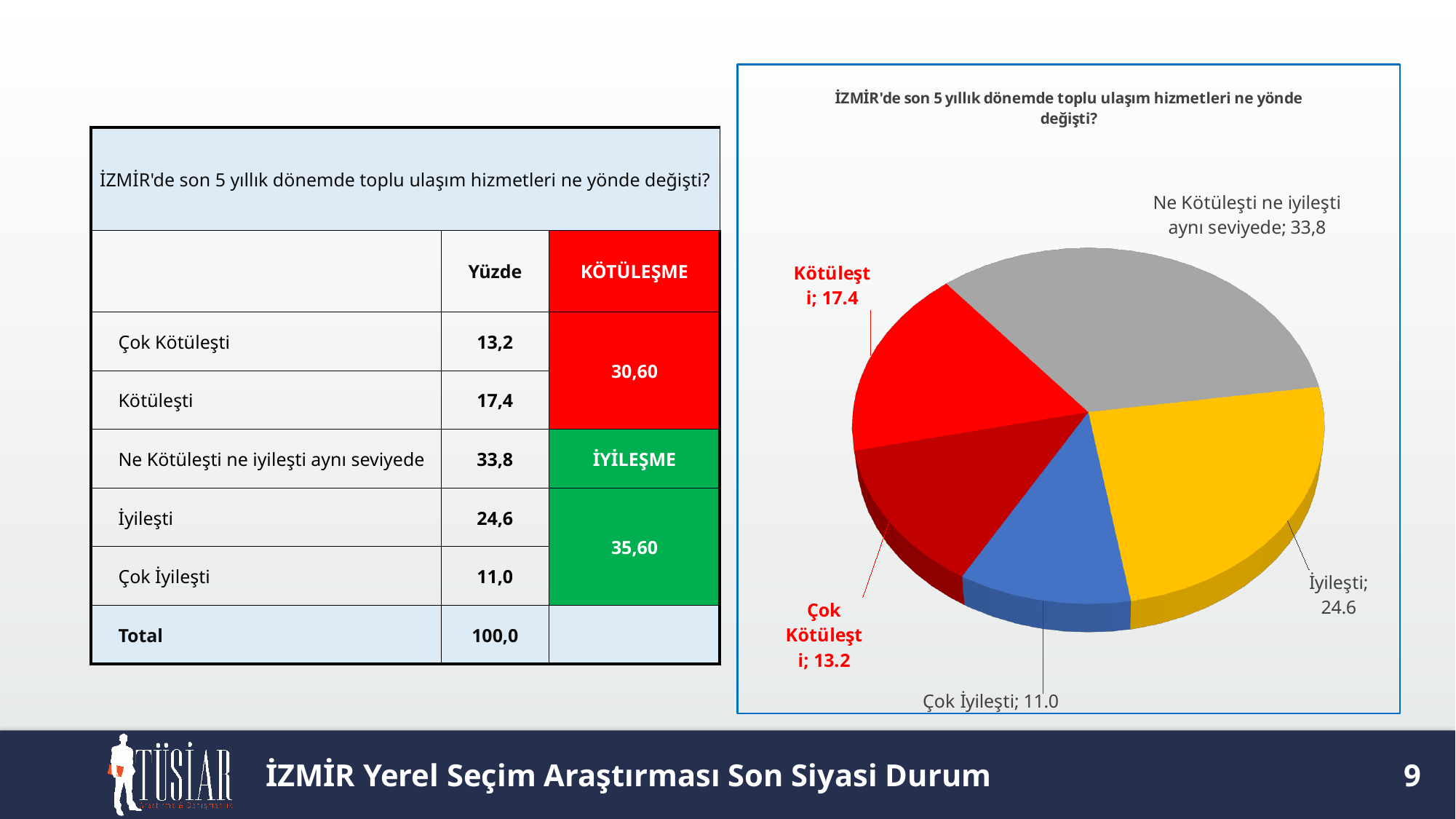
Which slice of the pie chart is the smallest? Çok İyileşti What is the value for the "İyileşti" slice in the pie chart? 24.6 How many slices does the pie chart have? 5 What is the difference between the "Kötüleşti" and "Çok Kötüleşti" values in the pie chart? 4.2 Which is larger in the pie chart, "İyileşti" or "Kötüleşti"? İyileşti What is the value for the "Ne Kötüleşti ne iyileşti aynı seviyede" slice in the pie chart? 33,8 What is the value for the "Çok İyileşti" slice in the pie chart? 11.0 What is the value for the "Kötüleşti" slice in the pie chart? 17.4 Which slice of the pie chart is the largest? Ne Kötüleşti ne iyileşti aynı seviyede What is the title of the pie chart? İZMİR'de son 5 yıllık dönemde toplu ulaşım hizmetleri ne yönde değişti? What kind of chart is shown on the slide? pie chart What colour is the "İyileşti" slice in the pie chart? yellow